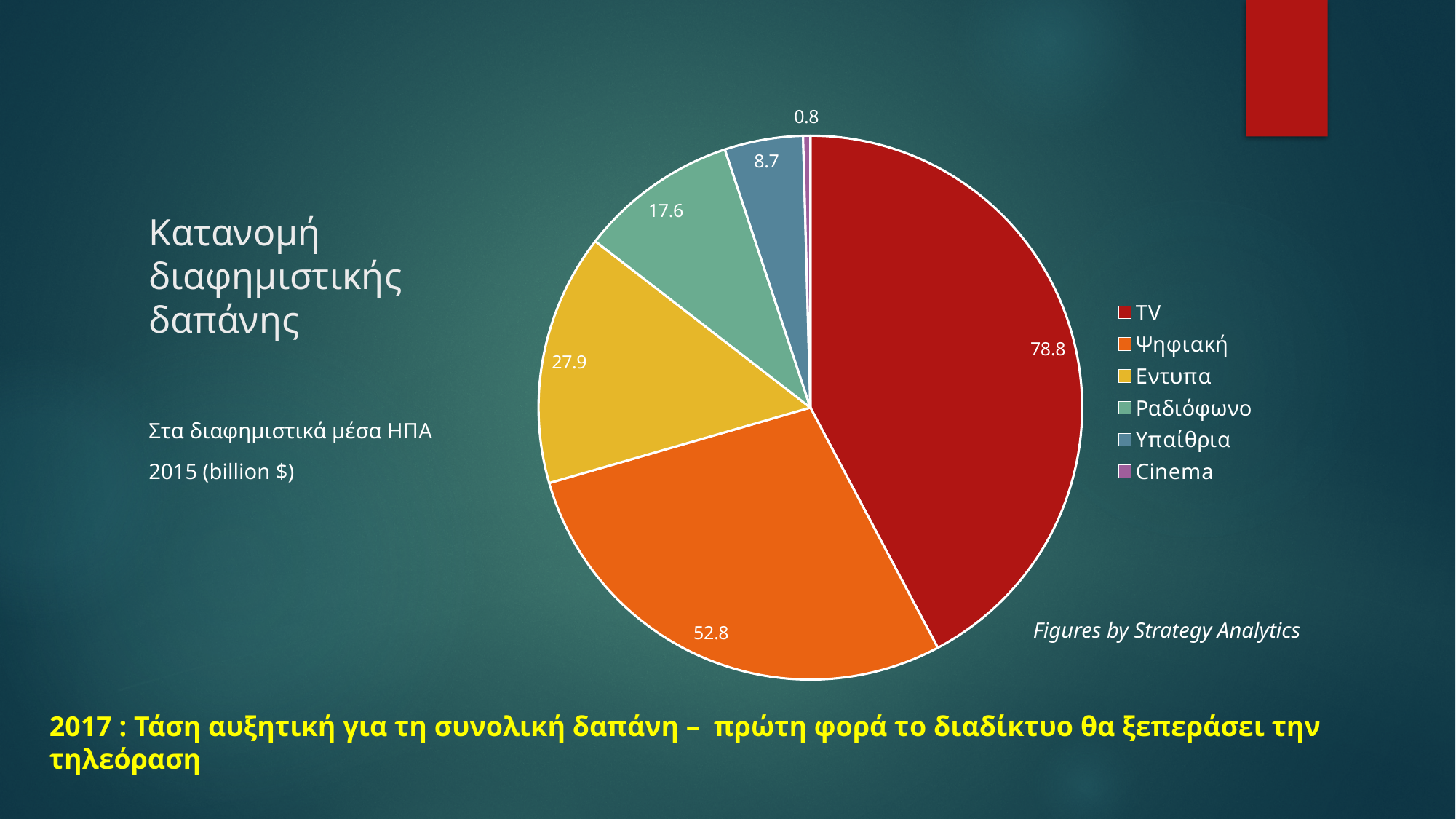
What is the value for Cinema in the pie chart? 0.8 What is the difference between the values for TV and Ψηφιακή? 26.0 What is the value for TV in the pie chart? 78.8 Which category has the largest slice of the pie chart? TV Which category has the smallest slice of the pie chart? Cinema Which is larger, the value for Υπαίθρια or the value for Ραδιόφωνο? Ραδιόφωνο What is the total of all the values shown in the pie chart? 186.6 What kind of chart is shown on the slide? Pie chart How many categories does the pie chart show? 6 What is the value for Ραδιόφωνο in the pie chart? 17.6 What is the difference between the values for Εντυπα and Ραδιόφωνο? 10.3 What is the value for Ψηφιακή in the pie chart? 52.8